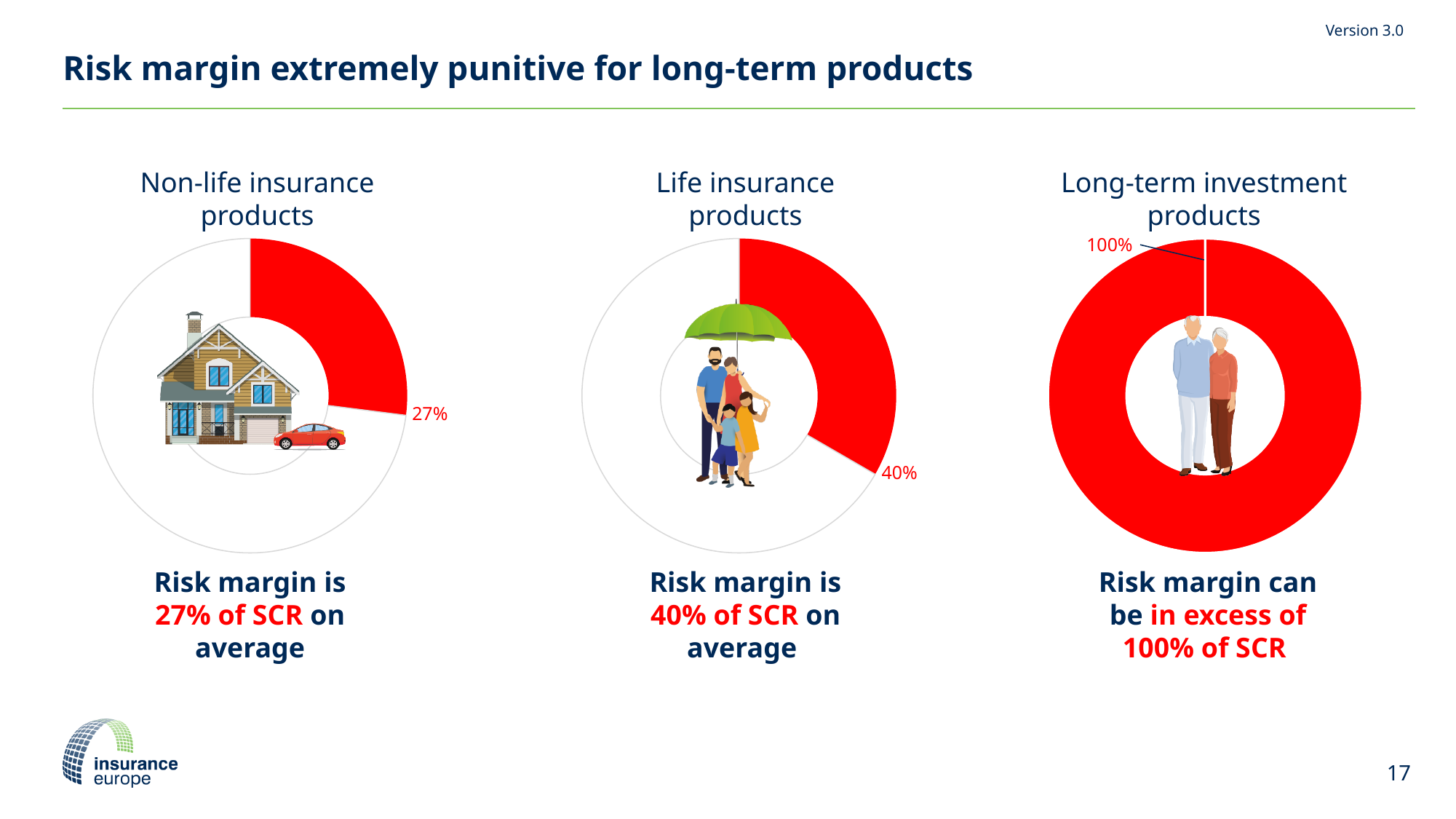
In the 'Long-term investment products' chart, what percentage is shown for the red slice? 100% How many charts are shown on the slide? 3 Which is larger: the percentage in the 'Life insurance products' chart or the percentage in the 'Non-life insurance products' chart? Life insurance products In the 'Non-life insurance products' chart, what percentage is shown for the red slice? 27% Which of the three charts on the slide shows the lowest percentage? Non-life insurance products What is the difference between the percentage in the 'Long-term investment products' chart and the percentage in the 'Life insurance products' chart? 60% Which of the three charts on the slide shows the highest percentage? Long-term investment products What colour is the filled slice in each of the three charts? Red What is the title of the chart on the right of the slide? Long-term investment products What kind of chart is used for 'Non-life insurance products'? Doughnut (pie) chart In the 'Life insurance products' chart, what percentage is shown for the red slice? 40% What is the difference between the percentage in the 'Life insurance products' chart and the percentage in the 'Non-life insurance products' chart? 13%